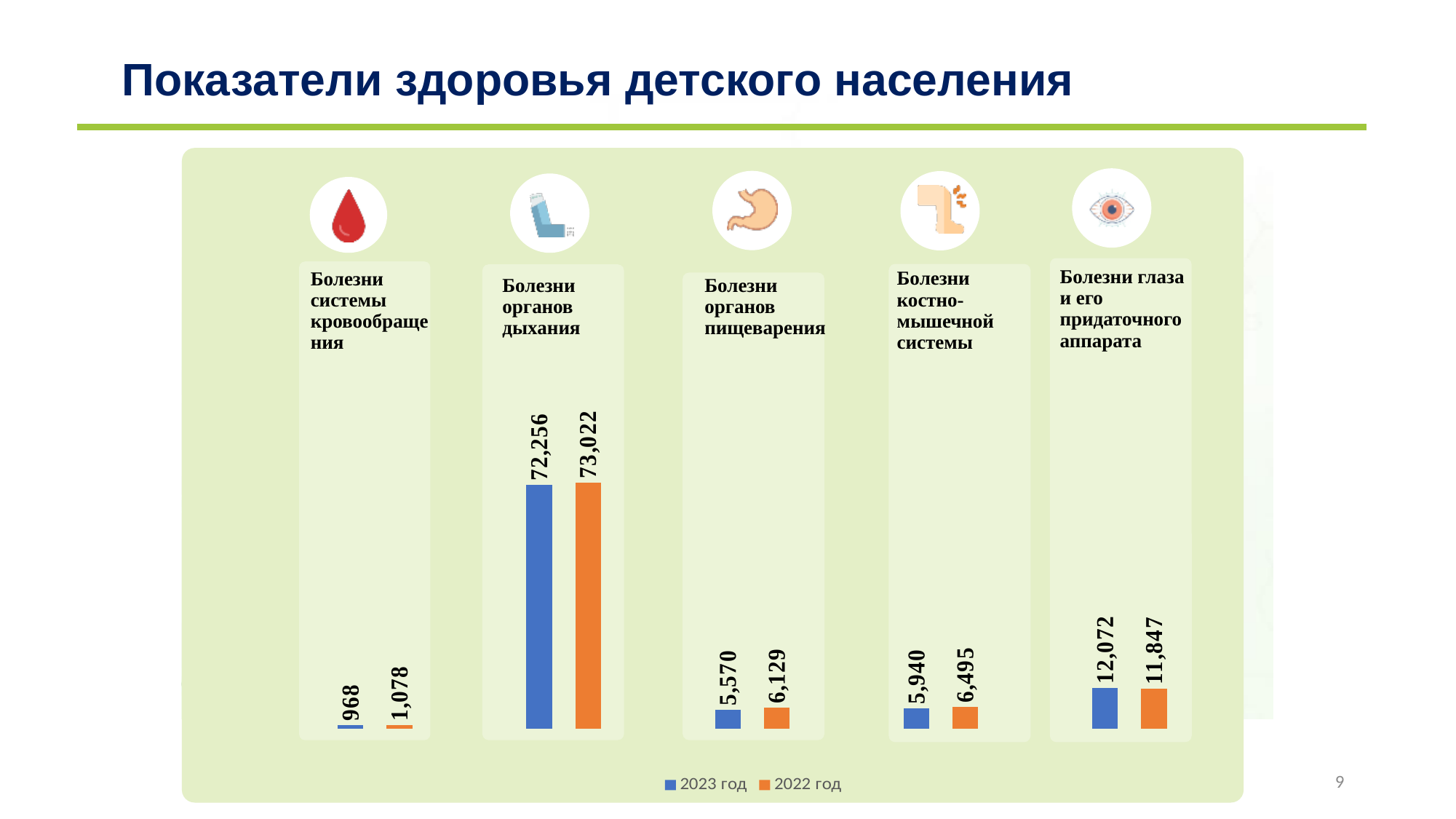
What is the 2022 год value for Болезни системы кровообращения? 1,078 How many series does the legend list? 2 Which category has the highest 2023 год value? Болезни органов дыхания What is the 2022 год value for Болезни костно-мышечной системы? 6,495 What kind of chart is shown on the slide? Bar chart What is the 2023 год value for Болезни органов дыхания? 72,256 Which category has the lowest 2022 год value? Болезни системы кровообращения What is the difference between the 2023 год and 2022 год values for Болезни глаза и его придаточного аппарата? 225 For Болезни органов пищеварения, which is larger: the 2023 год value or the 2022 год value? 2022 год What is the difference between the 2022 год and 2023 год values for Болезни органов дыхания? 766 What is the 2023 год value for Болезни глаза и его придаточного аппарата? 12,072 How many disease categories are shown in the chart? 5